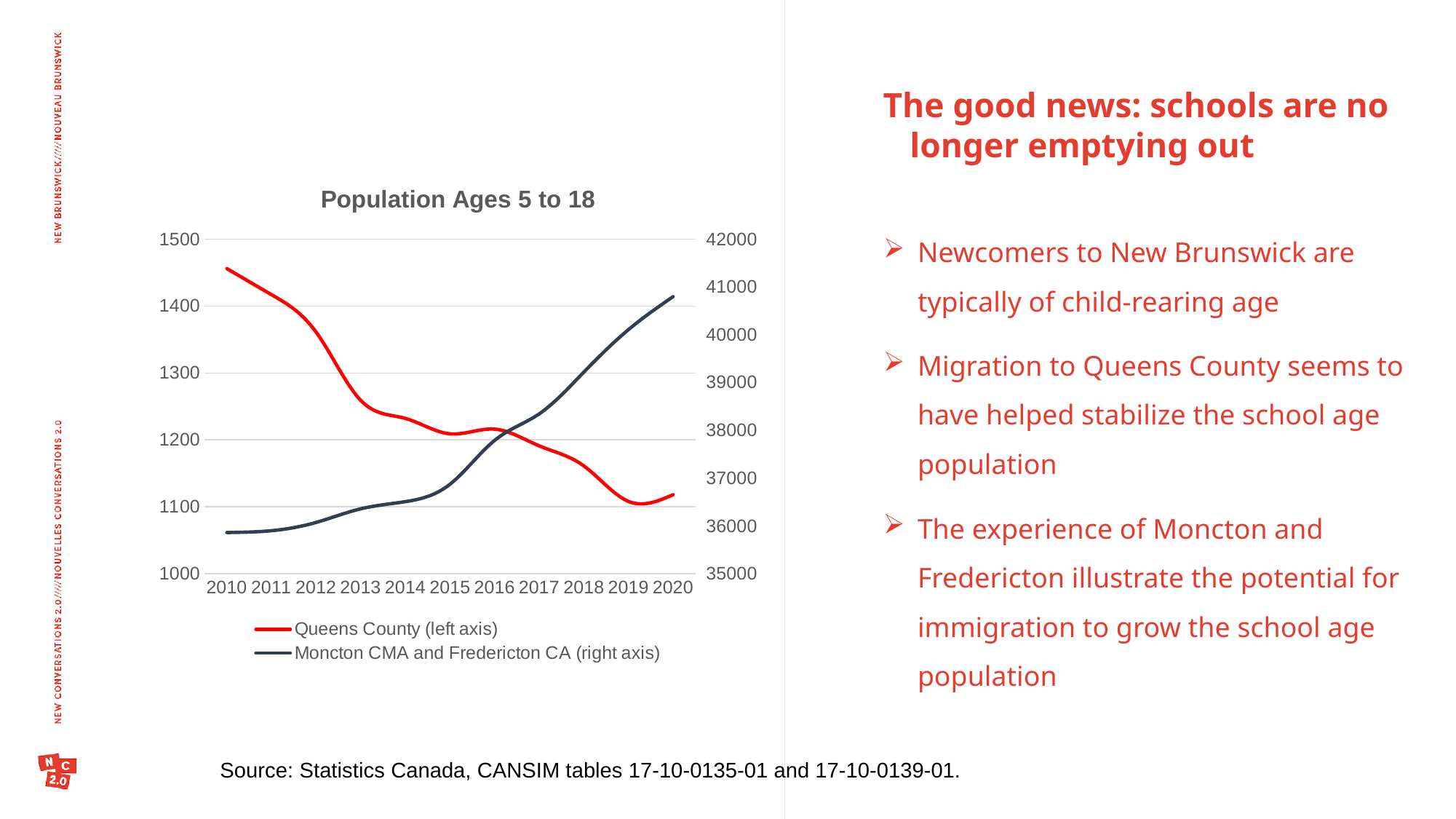
Is the Queens County value for 2020 greater or less than 1200? less What is the title of the chart? Population Ages 5 to 18 How many years are shown along the x axis of the chart? 11 Is the Moncton CMA and Fredericton CA value for 2020 greater or less than 40000? greater What kind of chart is shown on the slide? line chart Does the Queens County line rise or fall overall from 2010 to 2020? fall How many series does the chart's legend list? 2 Which series is plotted on the right axis? Moncton CMA and Fredericton CA In which year is the Queens County value highest? 2010 Does the Moncton CMA and Fredericton CA line rise or fall overall from 2010 to 2020? rise Is the Queens County value for 2010 greater or less than 1400? greater In which year is the Moncton CMA and Fredericton CA value highest? 2020